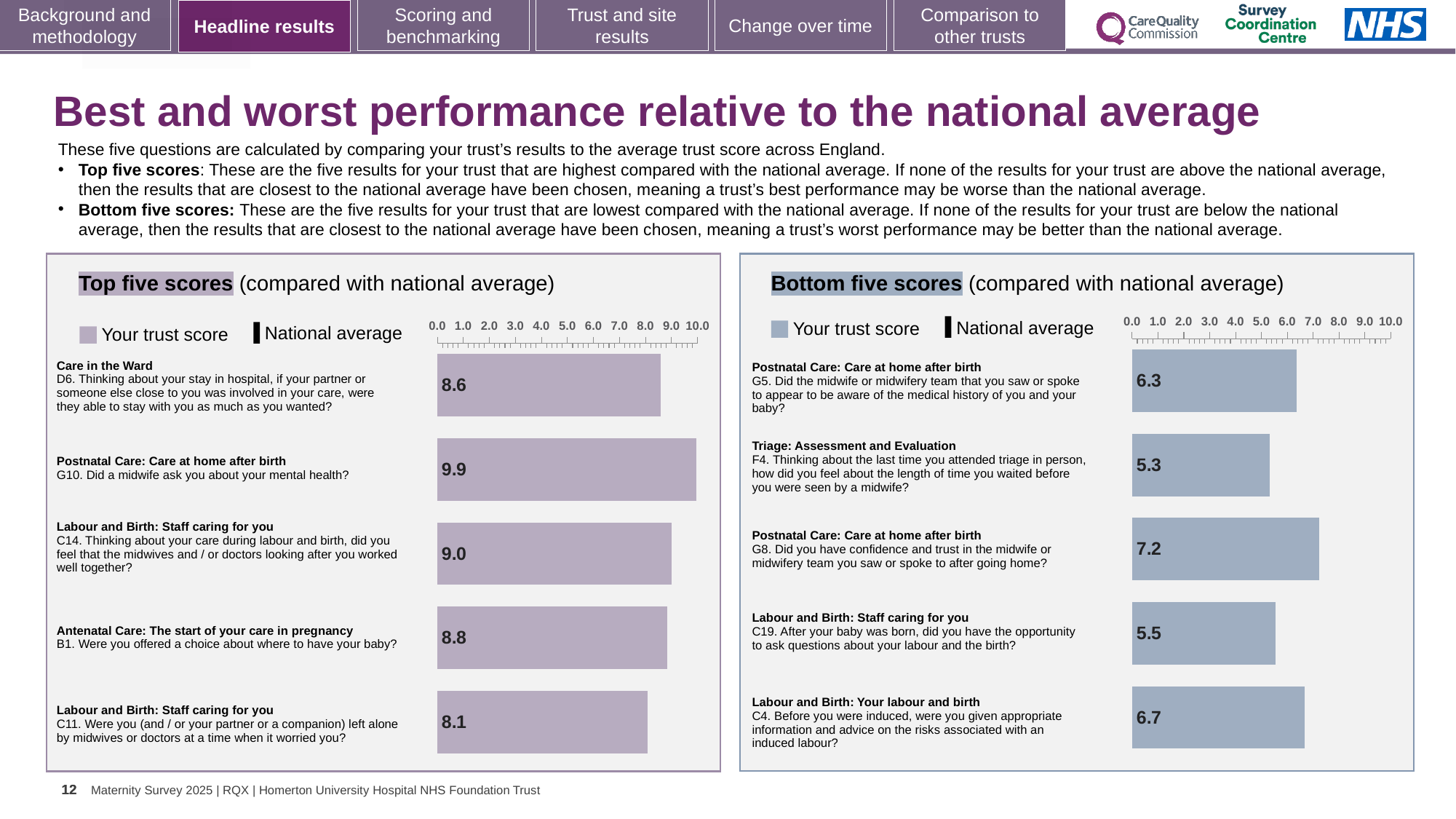
How many bars are shown in the Bottom five scores chart? 5 In the Bottom five scores chart, which has the larger trust score, G8 or C4? G8 (7.2) In the Bottom five scores chart, what is the trust score for F4 (length of time you waited in triage before being seen by a midwife)? 5.3 In the Top five scores chart, what is the trust score for B1 (Were you offered a choice about where to have your baby?)? 8.8 What type of chart is used in the Top five scores panel? Bar chart In the Bottom five scores chart, what is the difference between the trust scores for G8 and C19? 1.7 In the Top five scores chart, is the trust score for C14 greater or less than 8.0? greater In the Top five scores chart, which question has the highest trust score? G10 (Did a midwife ask you about your mental health?), 9.9 In the Bottom five scores chart, which question has the lowest trust score? F4 (Triage: length of time waited before seen by a midwife), 5.3 In the Top five scores chart, what is the difference between the trust scores for G10 and C11? 1.8 In the Top five scores chart, what is the trust score for G10 (Did a midwife ask you about your mental health?)? 9.9 What two entries does the legend of the Top five scores chart list? Your trust score; National average